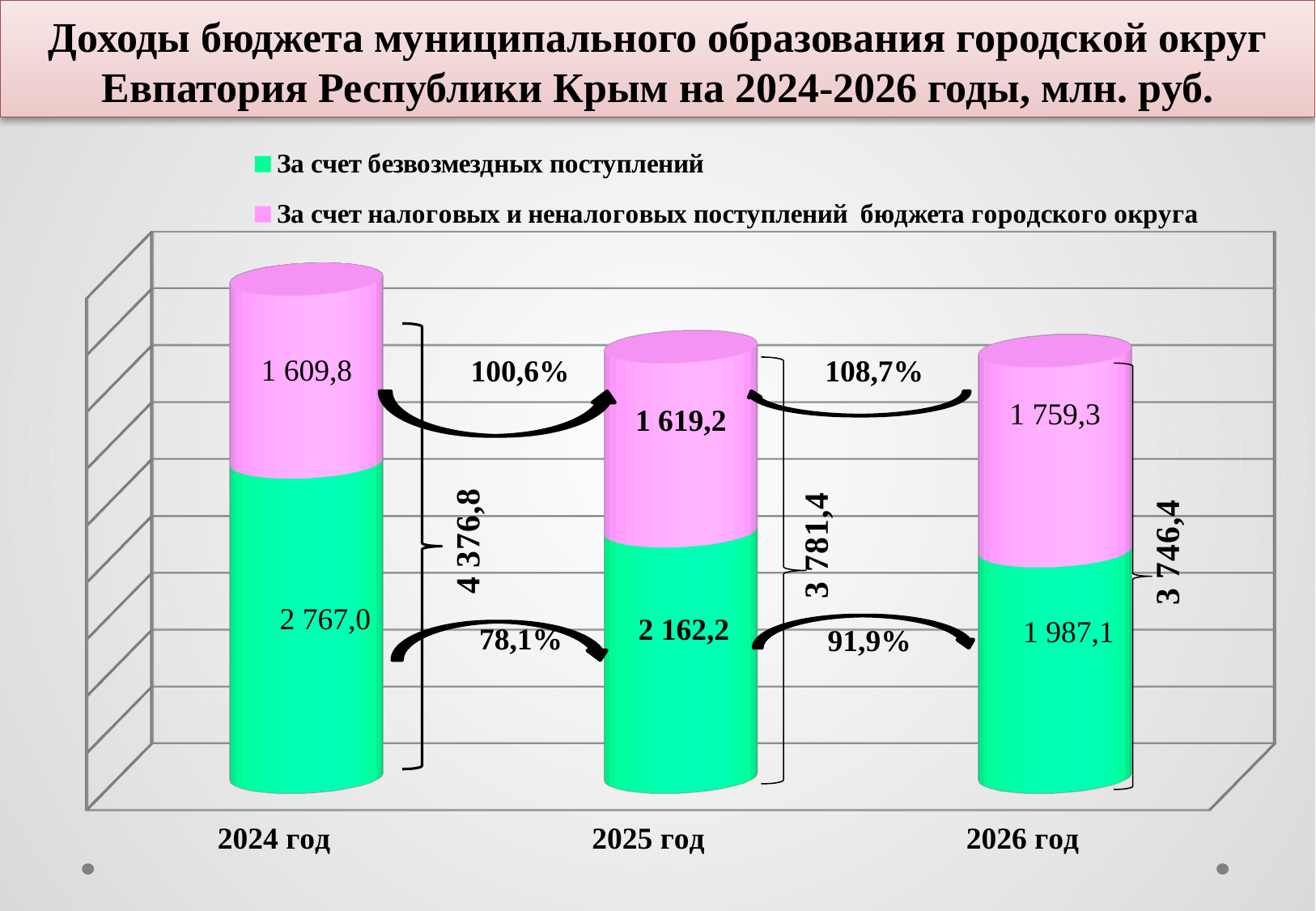
What is the value for 'За счет налоговых и неналоговых поступлений бюджета городского округа' in 2026 год? 1 759,3 What is the total of the stacked bar for 2026 год? 3 746,4 In which year is the value for 'За счет безвозмездных поступлений' the highest? 2024 год How many years (categories) are shown on the x axis? 3 What type of chart is shown on the slide? Stacked bar chart How many series does the legend list? 2 What is the value for 'За счет безвозмездных поступлений' in 2024 год? 2 767,0 In which year is the value for 'За счет налоговых и неналоговых поступлений бюджета городского округа' the lowest? 2024 год What is the difference between the 'За счет безвозмездных поступлений' values for 2024 год and 2025 год? 604,8 Does the total budget revenue rise or fall from 2024 год to 2026 год? Falls What is the value for 'За счет налоговых и неналоговых поступлений бюджета городского округа' in 2025 год? 1 619,2 What is the total of the stacked bar for 2025 год? 3 781,4